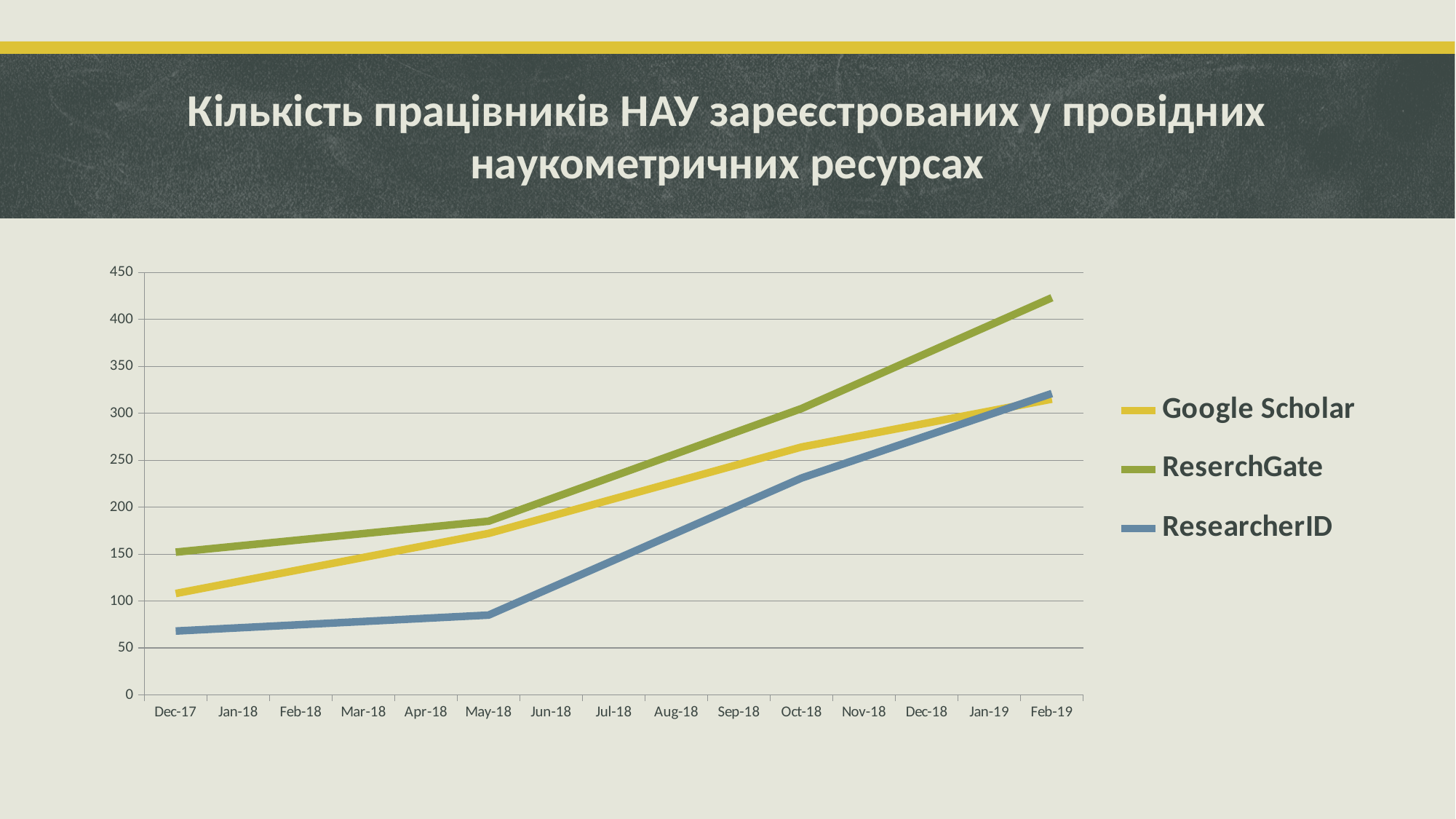
Which is larger at Dec-18, the value for Google Scholar or the value for ResearcherID? Google Scholar How many series does the legend list? 3 Is the value for ReserchGate at Feb-19 greater or less than 400? greater How many months are shown along the x axis? 15 Is the value for ResearcherID at Dec-17 greater or less than 100? less Do the values for ResearcherID rise or fall from Dec-17 to Feb-19? rise What kind of chart is shown on the slide? line chart Is the value for Google Scholar at Dec-17 greater or less than 150? less Which is larger at Jun-18, the value for ReserchGate or the value for ResearcherID? ReserchGate Which series is drawn in blue? ResearcherID Which series has the lowest value at Dec-17? ResearcherID Which series has the highest value at Feb-19? ReserchGate